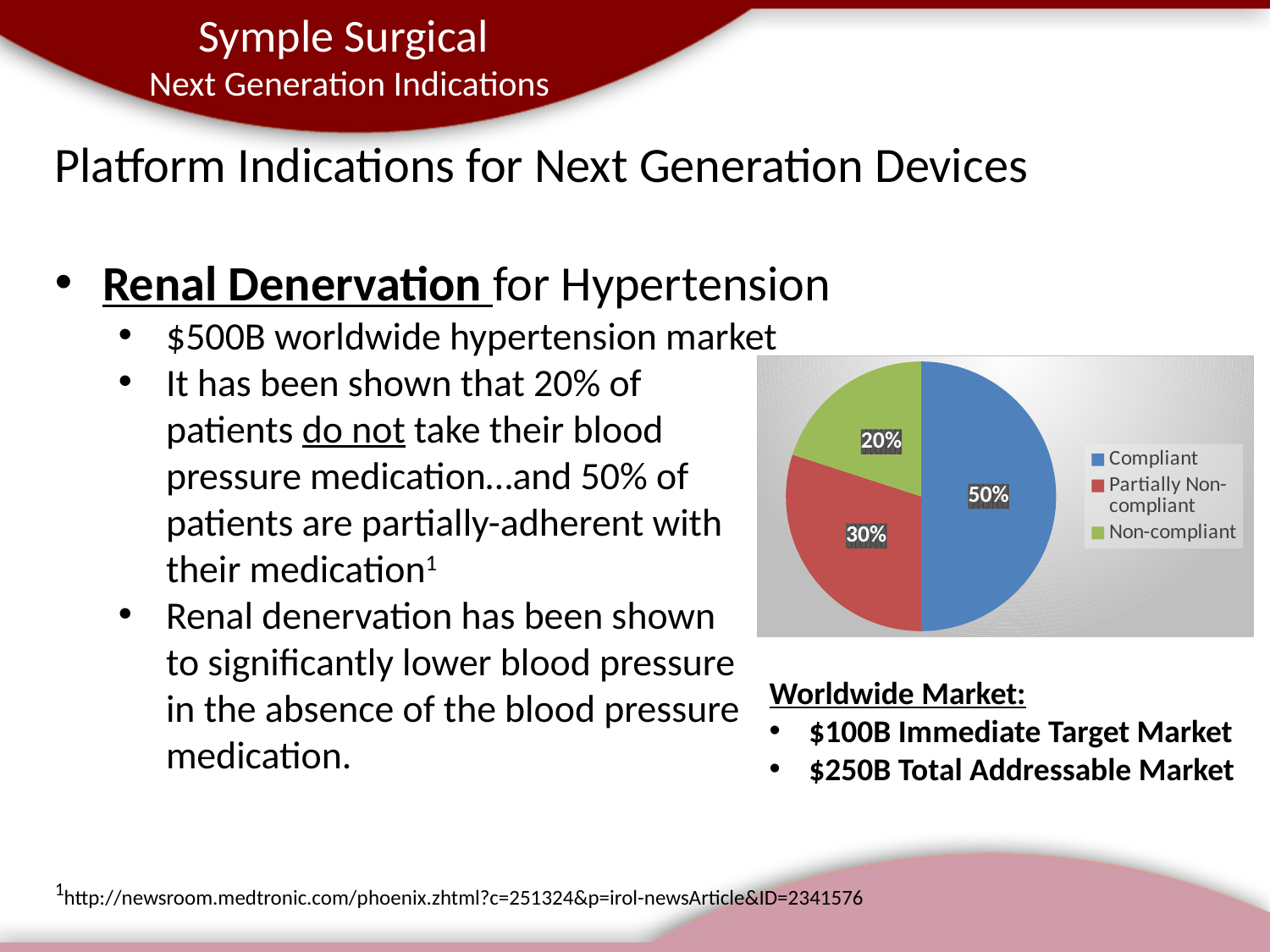
Which slice of the pie chart is the smallest? Non-compliant How many entries does the legend of the pie chart list? 3 What share of the pie is labelled Non-compliant? 20% What is the difference between the Partially Non-compliant share and the Non-compliant share? 10% What colour is the Compliant slice in the pie chart? blue Which slice of the pie chart is the largest? Compliant Which is larger, the Partially Non-compliant slice or the Non-compliant slice? Partially Non-compliant How many slices does the pie chart have? 3 What share of the pie is labelled Compliant? 50% What is the difference between the Compliant share and the Non-compliant share? 30% What kind of chart is shown on the slide? pie chart What share of the pie is labelled Partially Non-compliant? 30%